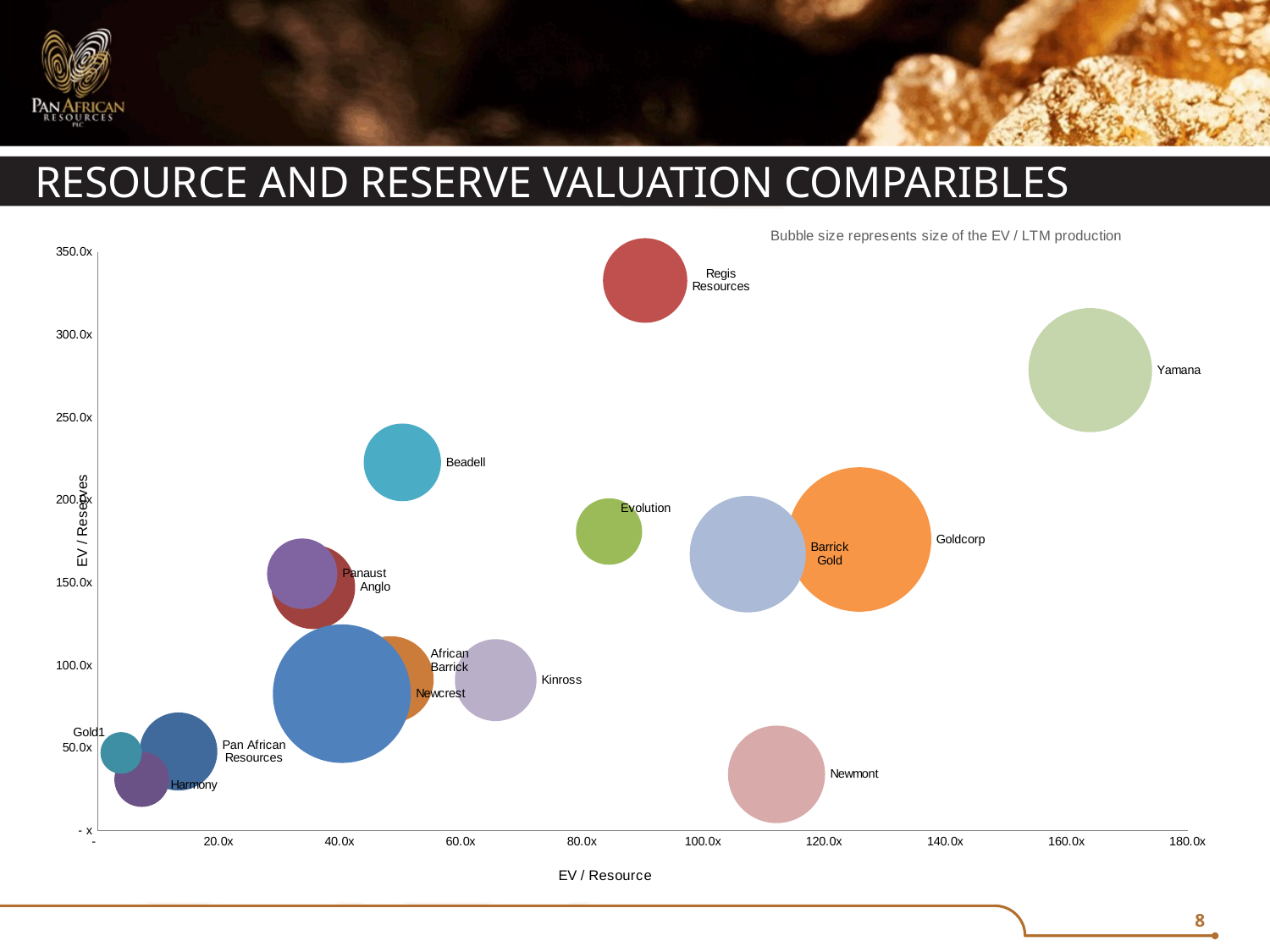
Is the EV / Resource value for Yamana greater or less than 140.0x? greater Which company has the highest EV / Resource value? Yamana Which company has the lowest EV / Resource value? Gold1 Which has the larger EV / Resource value, Kinross or Newcrest? Kinross Is the EV / Resource value for Newmont greater or less than 100.0x? greater Is the EV / Reserves value for Newmont greater or less than 50.0x? less Which company has the highest EV / Reserves value? Regis Resources Which has the larger EV / Resource value, Goldcorp or Barrick Gold? Goldcorp What kind of chart is shown on the slide? Bubble chart According to the note on the chart, what does the bubble size represent? Size of the EV / LTM production How many companies are plotted on the chart? 16